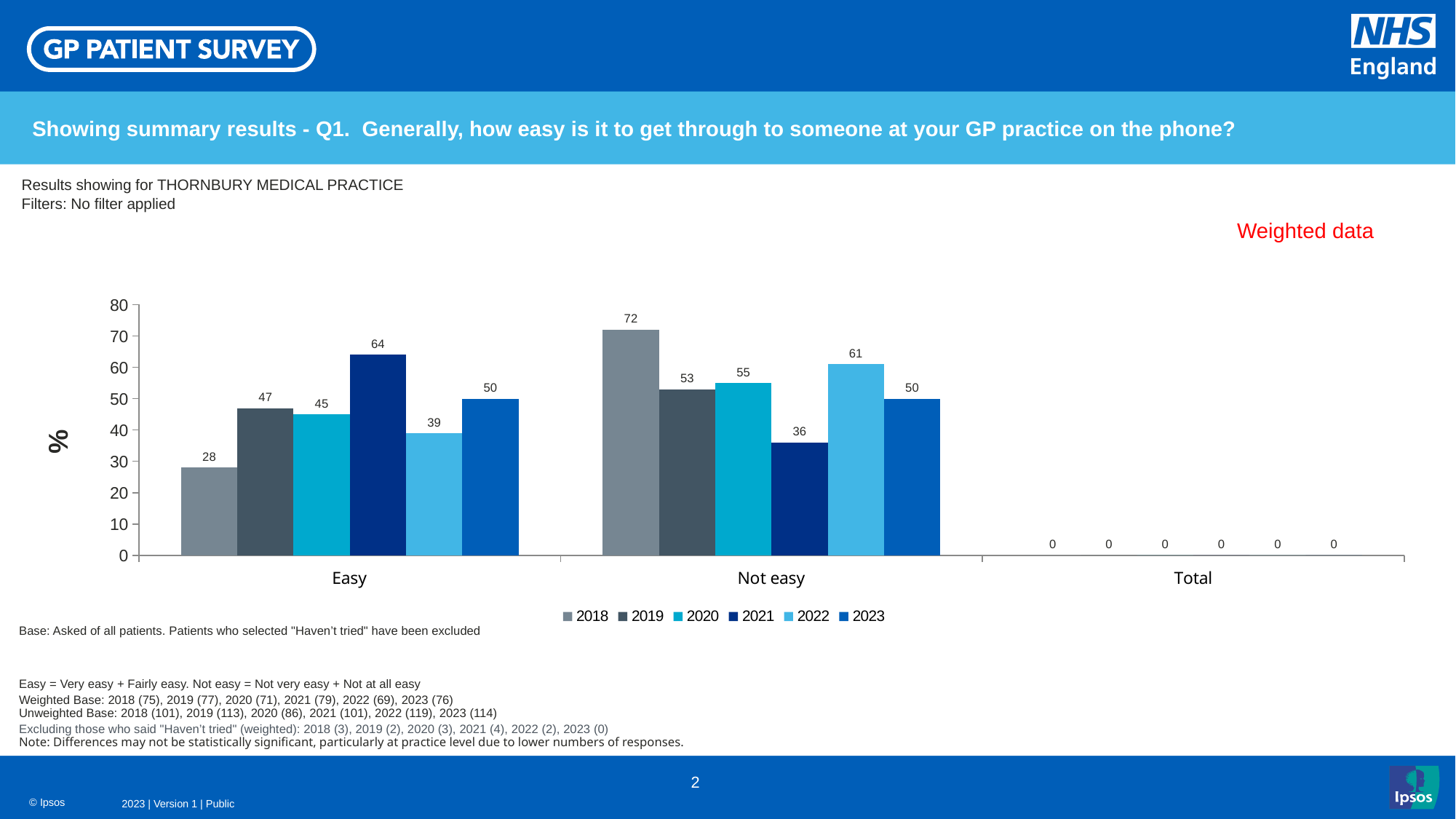
How many series does the legend list? 6 Which is larger in the Not easy category: the value for 2019 or the value for 2022? 2022 Which year has the lowest value in the Not easy category? 2021 Which year has the highest value in the Easy category? 2021 What is the value for 2022 in the Easy category? 39 What is the difference between the 2018 and 2023 values in the Easy category? 22 Which year has the lowest value in the Easy category? 2018 What is the value for 2021 in the Easy category? 64 What kind of chart is shown on the slide? Bar chart What is the value for 2018 in the Not easy category? 72 How many categories are shown on the x axis? 3 What is the label on the y axis? %